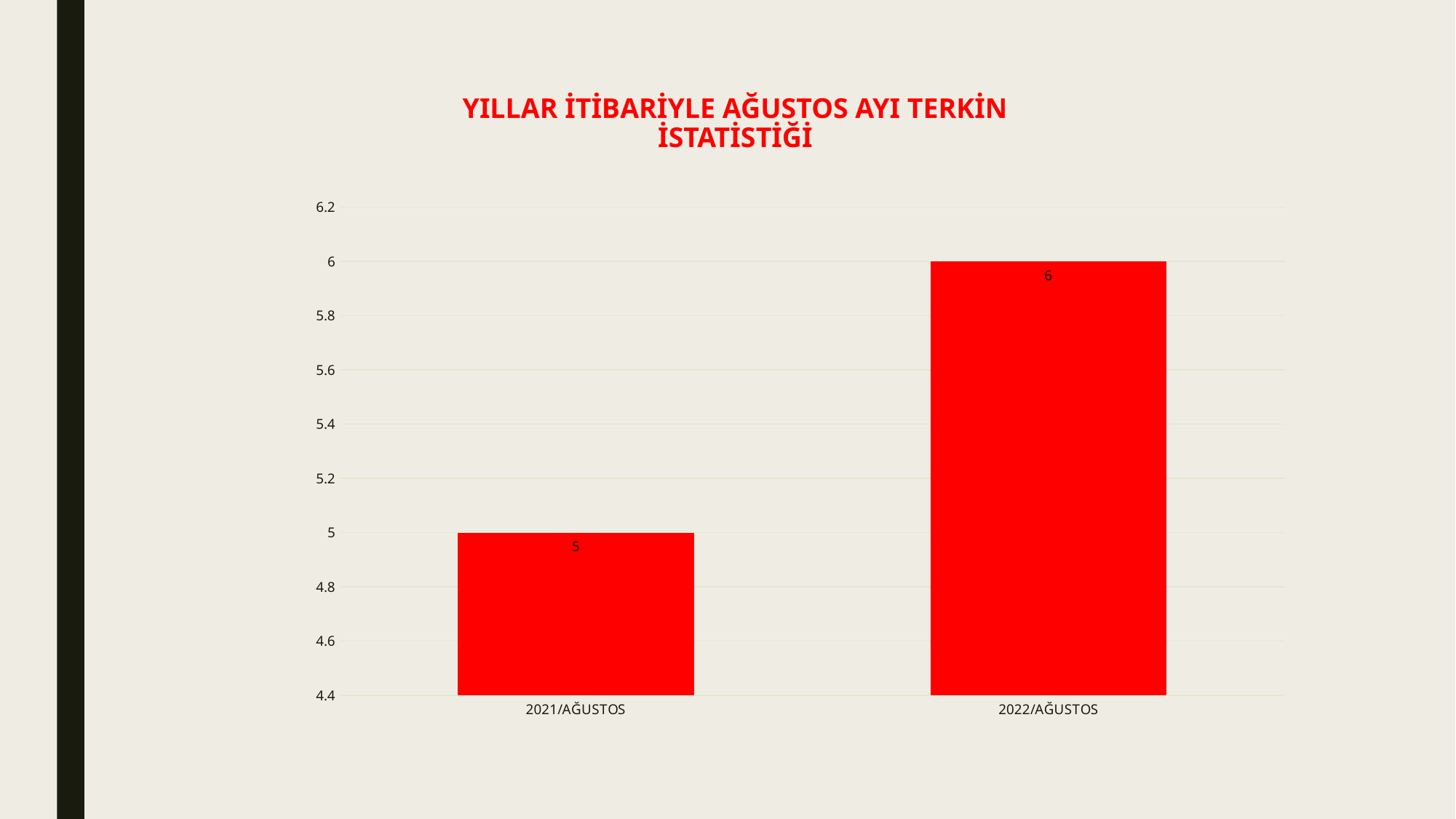
Is the value for 2022/AĞUSTOS greater or less than 5.6? greater Which category has the highest value? 2022/AĞUSTOS What is the title of the chart? YILLAR İTİBARİYLE AĞUSTOS AYI TERKİN İSTATİSTİĞİ How many categories are shown on the x axis? 2 What is the value for 2022/AĞUSTOS? 6 Which category has the lowest value? 2021/AĞUSTOS What is the difference between the values for 2022/AĞUSTOS and 2021/AĞUSTOS? 1 Is the value for 2021/AĞUSTOS greater or less than 5.4? less Which is larger, the value for 2021/AĞUSTOS or the value for 2022/AĞUSTOS? 2022/AĞUSTOS Do the values rise or fall from 2021/AĞUSTOS to 2022/AĞUSTOS? rise What kind of chart is shown on the slide? bar chart What is the value for 2021/AĞUSTOS? 5